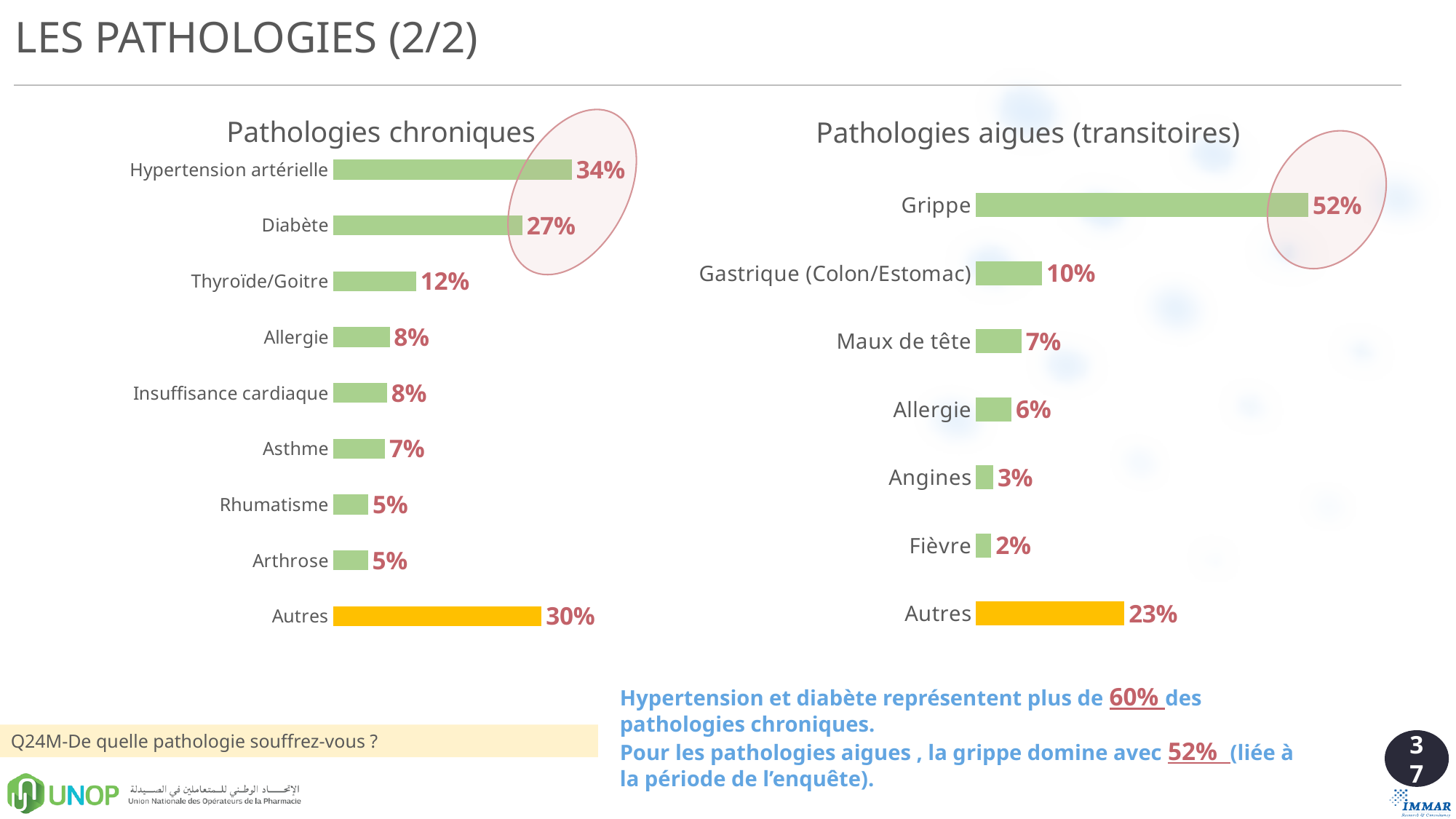
In the 'Pathologies aigues (transitoires)' chart, what is the value for Autres? 23% In the 'Pathologies chroniques' chart, what is the difference between Hypertension artérielle and Diabète? 7% In the 'Pathologies chroniques' chart, what is the value for Hypertension artérielle? 34% In the 'Pathologies aigues (transitoires)' chart, what is the value for Gastrique (Colon/Estomac)? 10% In the 'Pathologies aigues (transitoires)' chart, what is the difference between Grippe and Autres? 29% In the 'Pathologies chroniques' chart, which is larger, Diabète or Autres? Autres How many categories are shown in the 'Pathologies aigues (transitoires)' chart? 7 How many categories are shown in the 'Pathologies chroniques' chart? 9 In the 'Pathologies chroniques' chart, which category has the highest value? Hypertension artérielle What type of chart is the 'Pathologies aigues (transitoires)' chart? Bar chart In the 'Pathologies chroniques' chart, what is the value for Thyroïde/Goitre? 12% In the 'Pathologies aigues (transitoires)' chart, which category has the lowest value? Fièvre